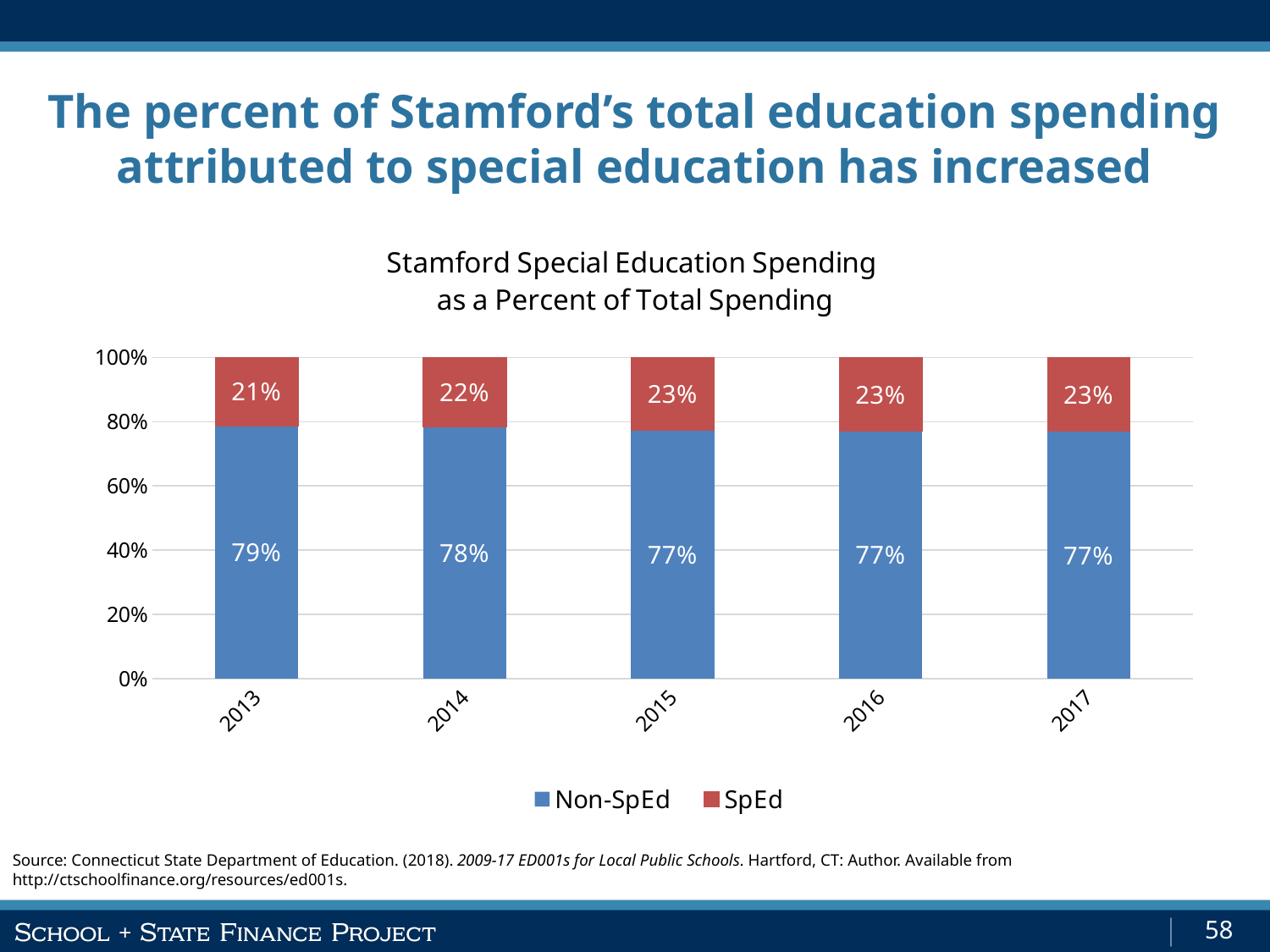
How many series does the legend list? 2 Which is larger in 2016, the Non-SpEd value or the SpEd value? Non-SpEd Does the SpEd value rise or fall from 2013 to 2017? Rise Which year has the highest Non-SpEd value? 2013 What is the Non-SpEd value for 2015? 77% What is the SpEd value for 2013? 21% What is the difference between the Non-SpEd and SpEd values in 2014? 56% Which year has the lowest SpEd value? 2013 What kind of chart is shown? Stacked bar chart What is the total of the stacked bar for 2015? 100% What is the SpEd value for 2017? 23% How many years are shown on the x axis? 5